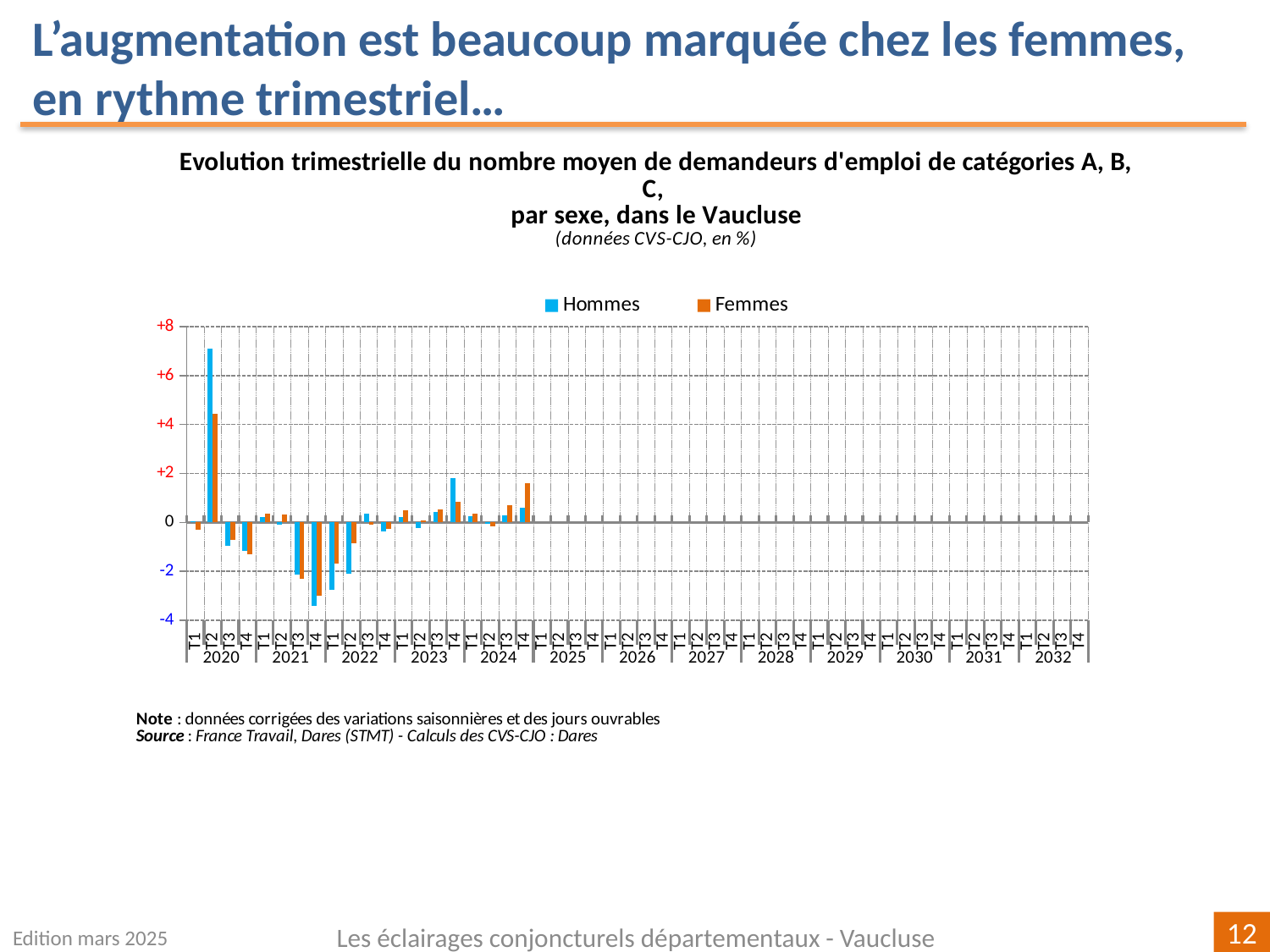
In T2 2020, which series has the larger value, Hommes or Femmes? Hommes Is the value for Hommes in T4 2021 greater or less than -2? less In which quarter is the value for Hommes the lowest? T4 2021 Which series is shown in orange? Femmes How many series does the legend list? 2 What kind of chart is shown on the slide? bar chart Is the value for Femmes in T2 2020 greater or less than +4? greater How many years are labelled along the x axis? 13 In which quarter is the value for Hommes the highest? T2 2020 Is the value for Hommes in T2 2020 greater or less than +6? greater In T4 2023, which series has the larger value, Hommes or Femmes? Hommes In T4 2024, which series has the larger value, Hommes or Femmes? Femmes